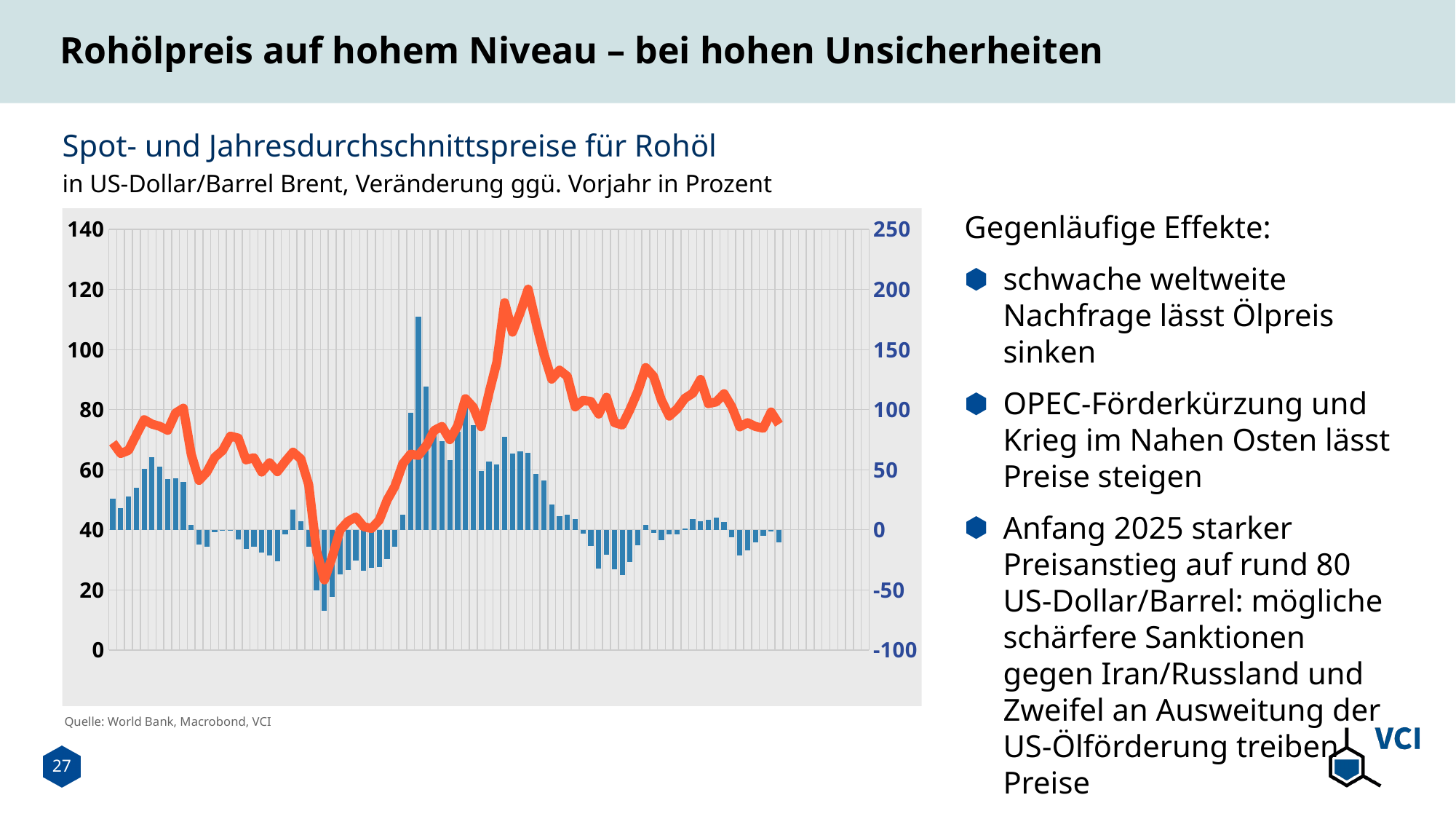
Does the orange line rise or fall over the last few points at the right end of the chart? fall Is the tallest blue bar greater or less than 150 on the right axis? greater Is the lowest point of the orange line greater or less than 40 on the left axis? less What is the highest value shown on the left axis of the chart? 140 What kind of chart is shown on the slide? A combined bar and line chart Is the highest point of the orange line greater or less than 100 on the left axis? greater What is the title of the chart? Spot- und Jahresdurchschnittspreise für Rohöl